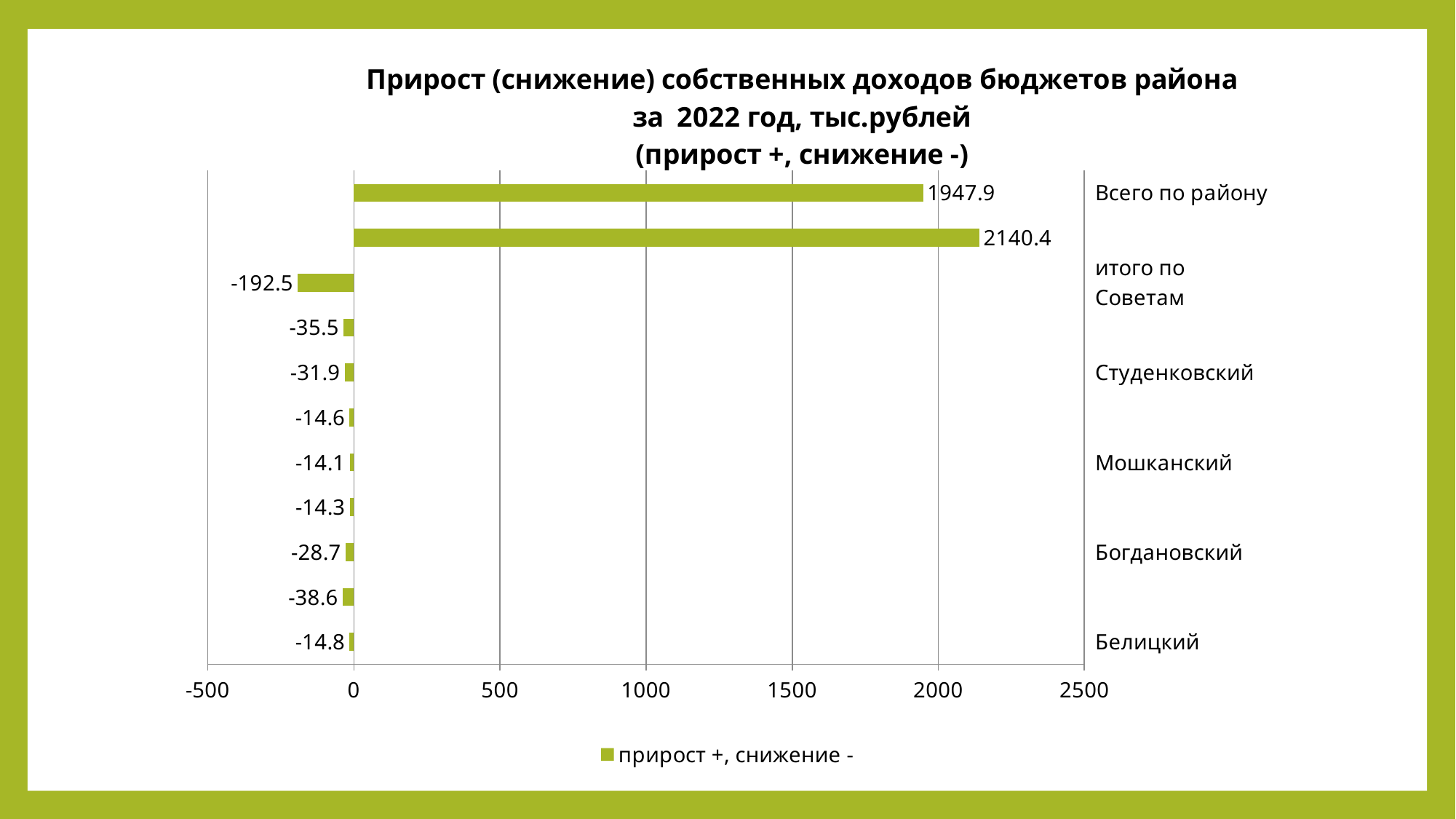
What is the difference between the values for Всего по району and итого по Советам? 2140.4 Is the value for Всего по району greater or less than 1500? greater What is the value for итого по Советам? -192.5 What is the value for Студенковский? -31.9 What is the value for Белицкий? -14.8 Which is larger, the value for Мошканский or the value for Белицкий? Мошканский What is the value for Богдановский? -28.7 What is the value for Всего по району? 1947.9 How many bars are plotted in the chart? 11 Which category has the lowest value? итого по Советам What kind of chart is shown on the slide? bar chart What is the value for Мошканский? -14.1